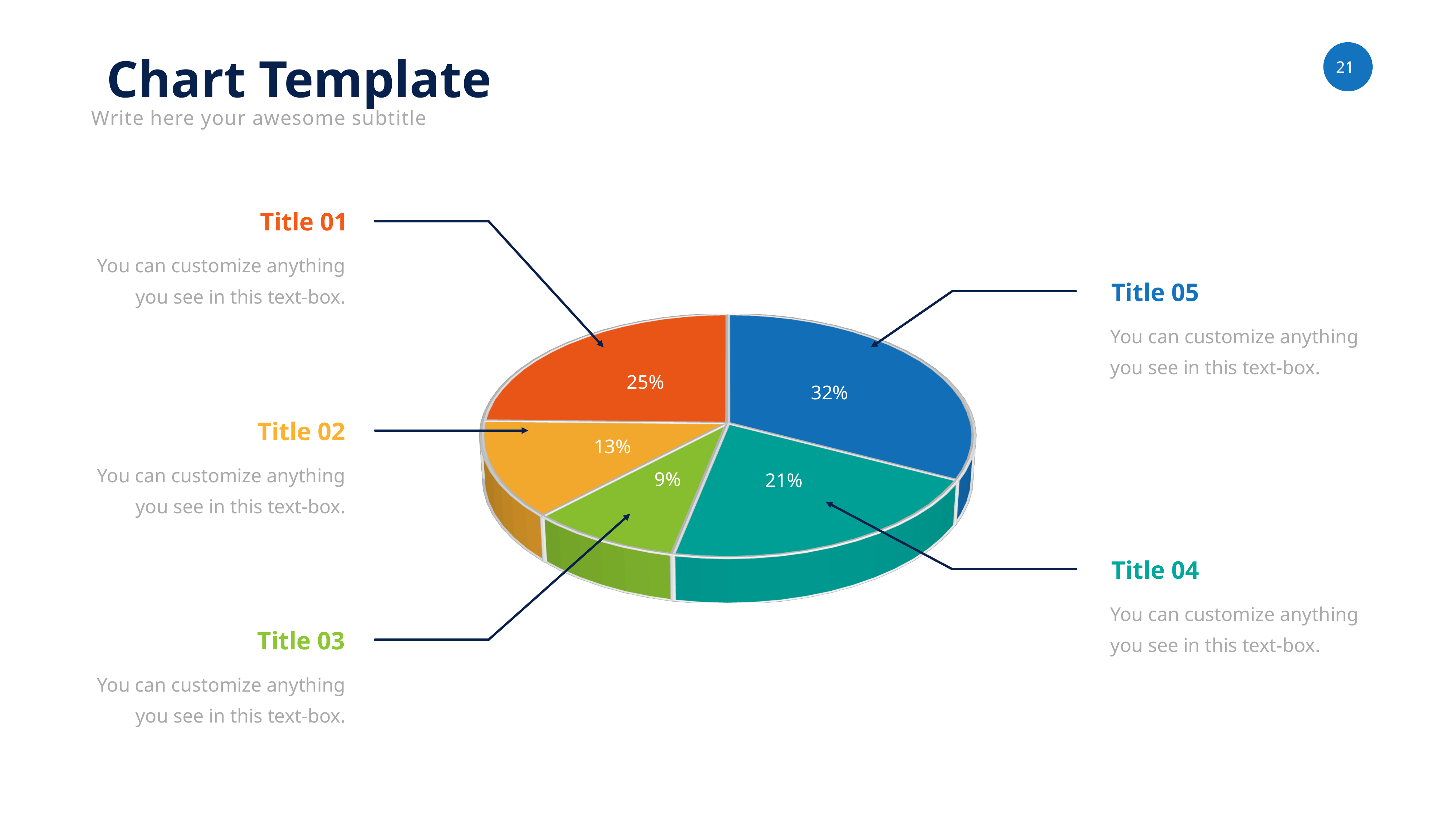
What kind of chart is shown on the slide? pie chart Which slice of the pie chart is the largest? Title 05 Which slice of the pie chart is the smallest? Title 03 How many slices does the pie chart have? 5 What percentage is shown for the Title 05 slice? 32% What percentage is shown for the Title 03 slice? 9% Which is larger, the Title 01 slice or the Title 02 slice? Title 01 What percentage is shown for the Title 01 slice? 25% What is the difference in percentage points between the Title 05 slice and the Title 04 slice? 11 What percentage is shown for the Title 02 slice? 13% What percentage is shown for the Title 04 slice? 21% What colour is the Title 04 slice of the pie chart? teal